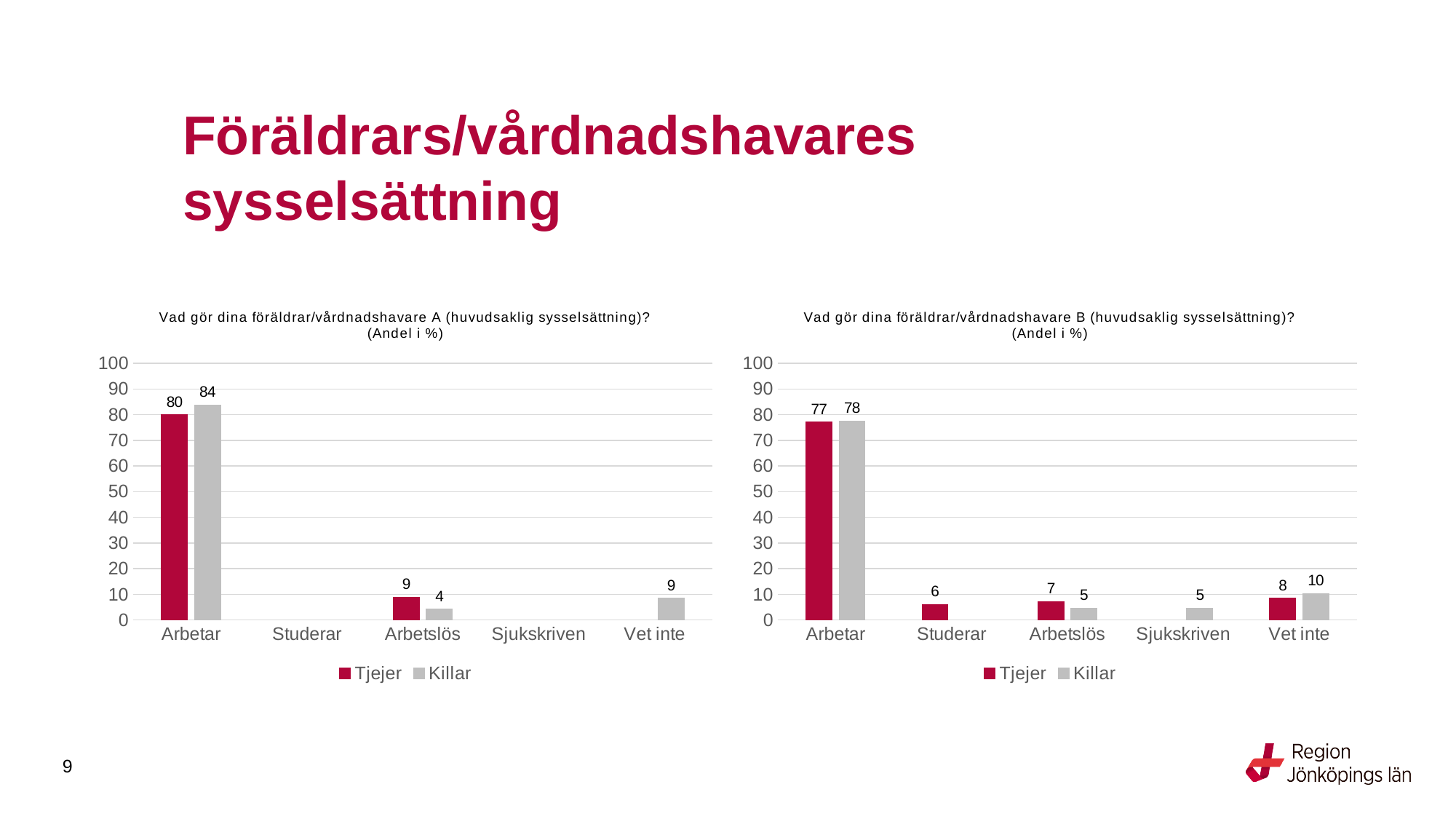
How many categories are shown on the x axis of the right chart (vårdnadshavare B)? 5 What kind of chart is the right chart (vårdnadshavare B)? Bar chart In the right chart (vårdnadshavare B), what is the difference between the Tjejer and Killar values for Arbetslös? 2 In the right chart (vårdnadshavare B), what is the value for Tjejer in the Arbetslös category? 7 In the left chart (vårdnadshavare A), what is the value for Killar in the Arbetar category? 84 In the left chart (vårdnadshavare A), which category has the highest value for Tjejer? Arbetar In the left chart (vårdnadshavare A), what is the difference between the Killar and Tjejer values for Arbetar? 4 How many series does the legend of the left chart (vårdnadshavare A) list? 2 In the left chart (vårdnadshavare A), which is larger for Arbetslös: Tjejer or Killar? Tjejer In the right chart (vårdnadshavare B), is the value for Tjejer in Arbetar greater or less than 50? greater In the left chart (vårdnadshavare A), what is the value for Tjejer in the Arbetar category? 80 In the right chart (vårdnadshavare B), what is the value for Killar in the Vet inte category? 10